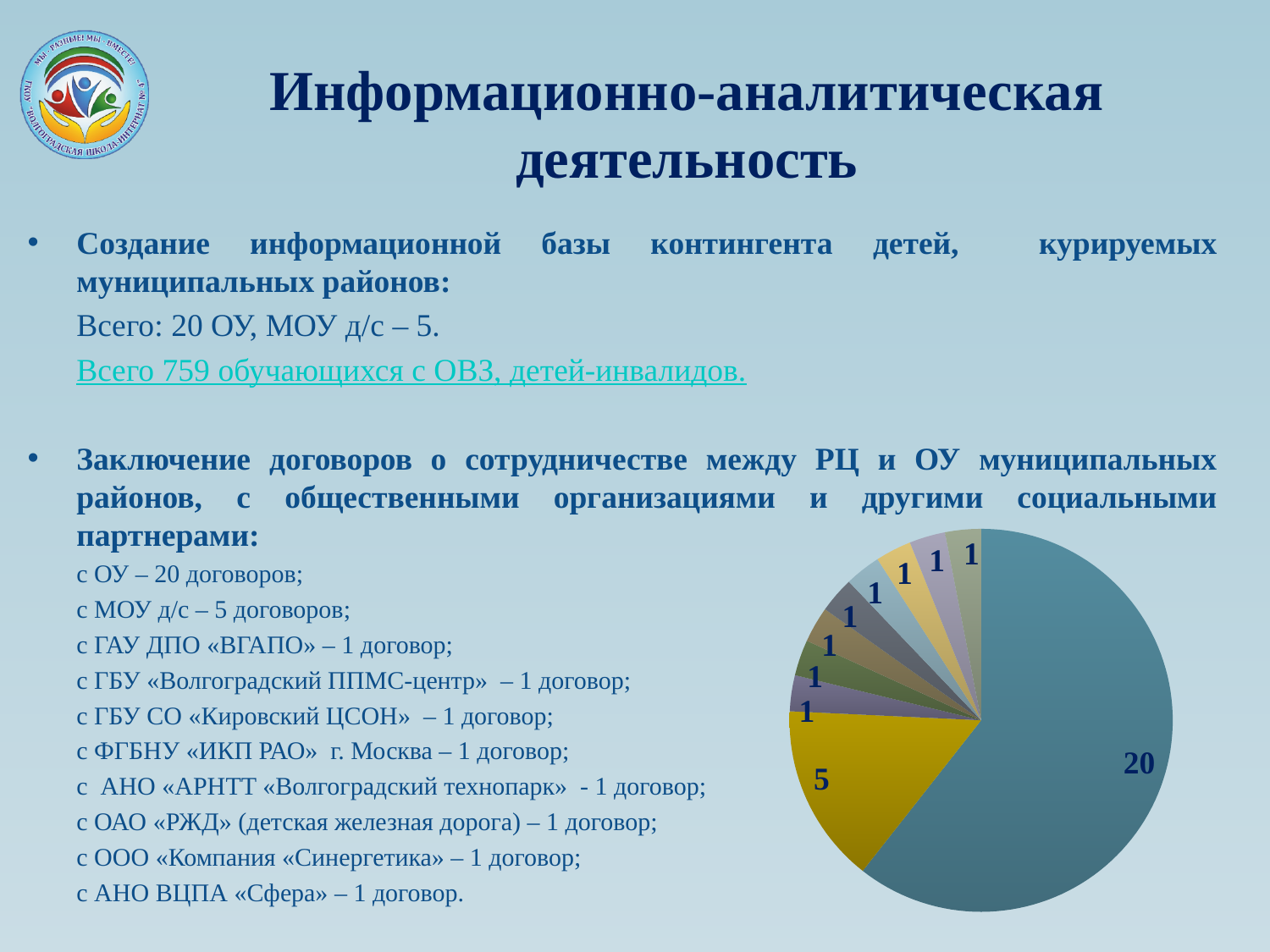
What type of chart is shown on the slide? pie chart What is the difference between the largest slice (20) and the second-largest slice (5) in the pie chart? 15 How many slices in the pie chart are labelled 1? 8 Which is larger in the pie chart: the slice labelled 20 or the slice labelled 5? the slice labelled 20 What is the value of the largest slice in the pie chart? 20 Does the pie chart display a legend? No What is the value of the smallest slices in the pie chart? 1 What colour is the slice labelled 5 in the pie chart? yellow Does the largest slice of the pie chart account for more or less than half of the pie? more How many slices does the pie chart have? 10 What is the value of the second-largest slice in the pie chart? 5 What is the total of all the slice values in the pie chart? 33